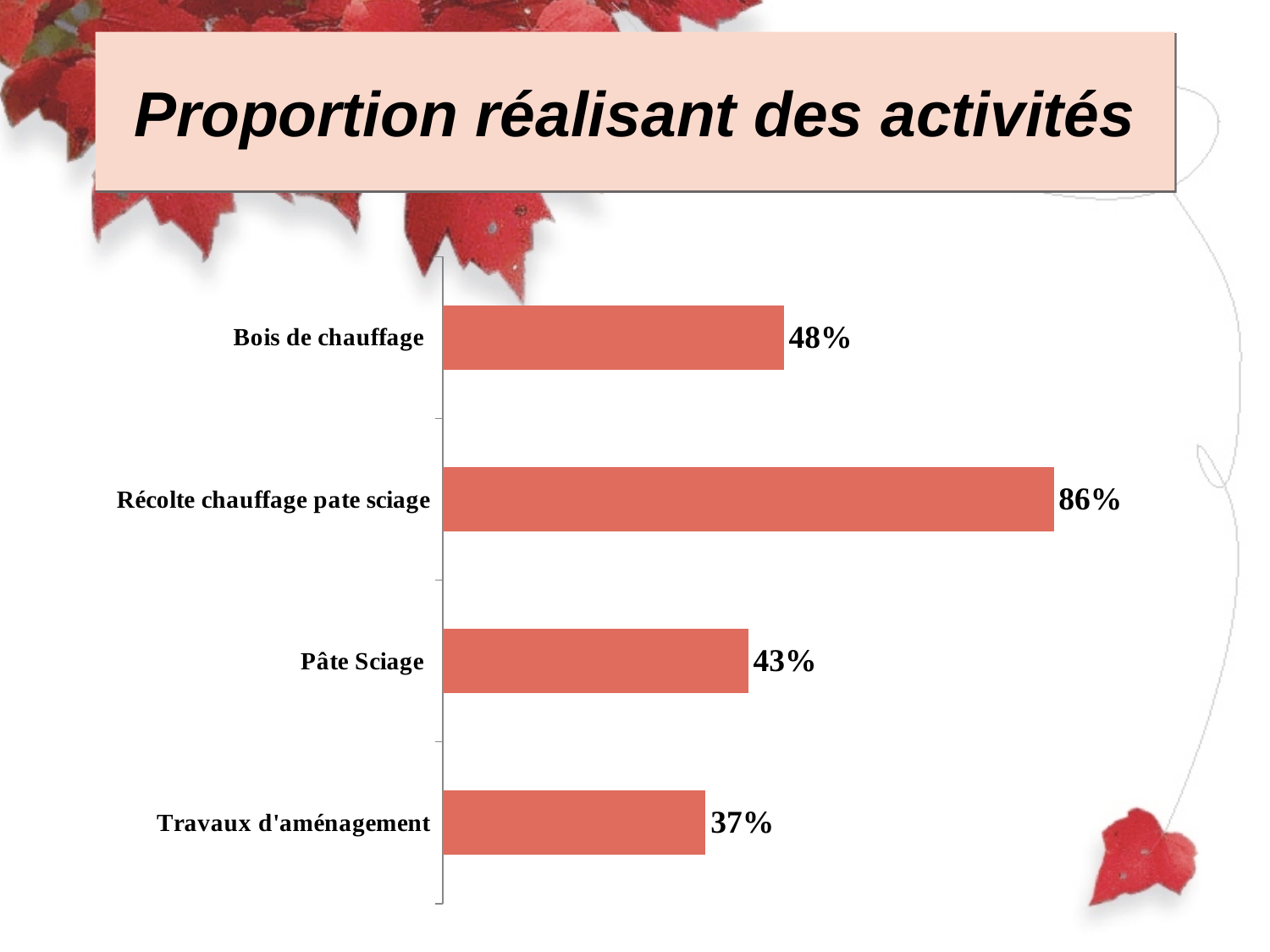
What is the difference between the values for Pâte Sciage and Travaux d'aménagement? 6% How many categories are shown in the chart? 4 Which is larger, the value for Bois de chauffage or the value for Pâte Sciage? Bois de chauffage What kind of chart is shown on the slide? Bar chart What is the value for Bois de chauffage? 48% Which category has the lowest value? Travaux d'aménagement Which category has the highest value? Récolte chauffage pate sciage What is the difference between the values for Récolte chauffage pate sciage and Bois de chauffage? 38% What is the value for Pâte Sciage? 43% What is the title of the slide? Proportion réalisant des activités What is the value for Récolte chauffage pate sciage? 86% What is the value for Travaux d'aménagement? 37%